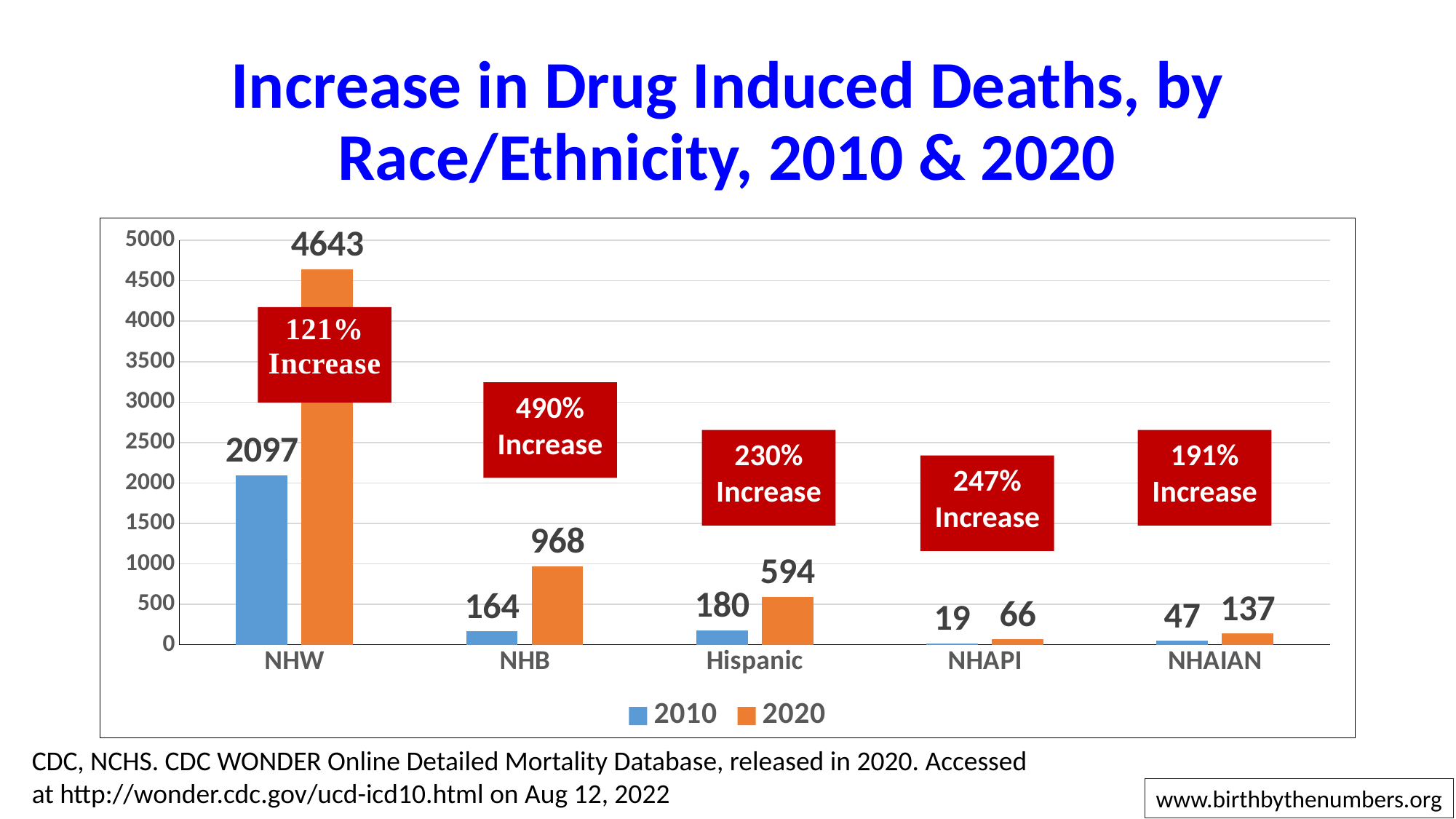
How many race/ethnicity categories are shown on the x axis? 5 What kind of chart is shown on the slide? Bar chart What percentage increase is shown in the red box above the NHB bars? 490% Increase Which category has the lowest 2010 value? NHAPI Which category has the highest 2020 value? NHW What is the 2010 value for NHB? 164 What is the 2020 value for Hispanic? 594 What is the 2010 value for NHAIAN? 47 What is the 2020 value for NHW? 4643 Which is larger, the 2020 value for Hispanic or the 2020 value for NHB? NHB How many series does the legend list? 2 What is the difference between the 2020 and 2010 values for NHB? 804